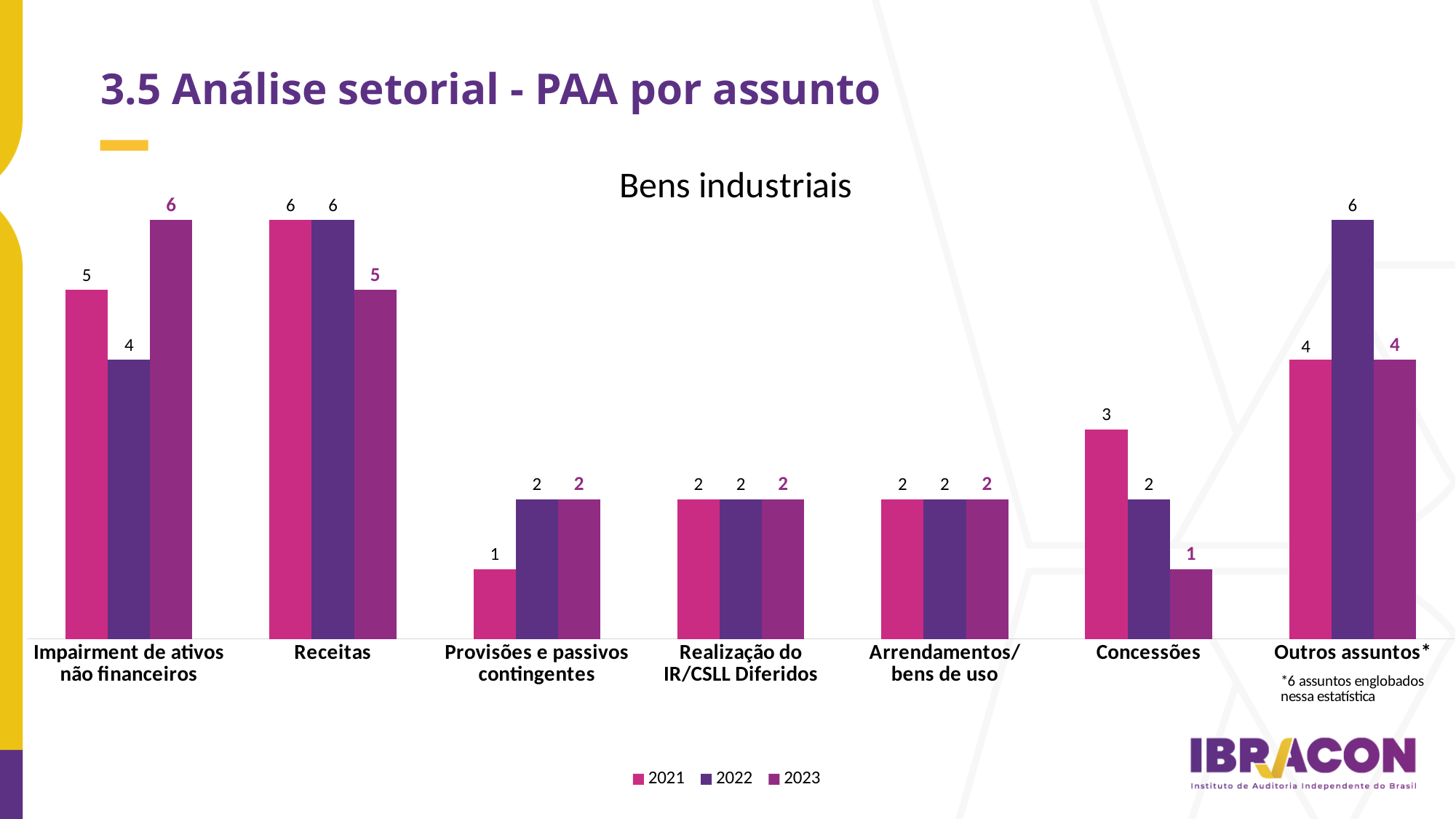
What is the value for Receitas in 2021? 6 Which category has the highest value in 2023? Impairment de ativos não financeiros What is the title of the chart? Bens industriais Which category has the lowest value in 2021? Provisões e passivos contingentes What kind of chart is shown on the slide? Bar chart How many series does the legend list? 3 What is the difference between the 2021 and 2023 values for Concessões? 2 What is the value for Concessões in 2023? 1 How many categories are shown on the x axis? 7 Which is larger for Impairment de ativos não financeiros: the 2021 value or the 2023 value? 2023 What is the value for Outros assuntos* in 2022? 6 What is the value for Impairment de ativos não financeiros in 2022? 4